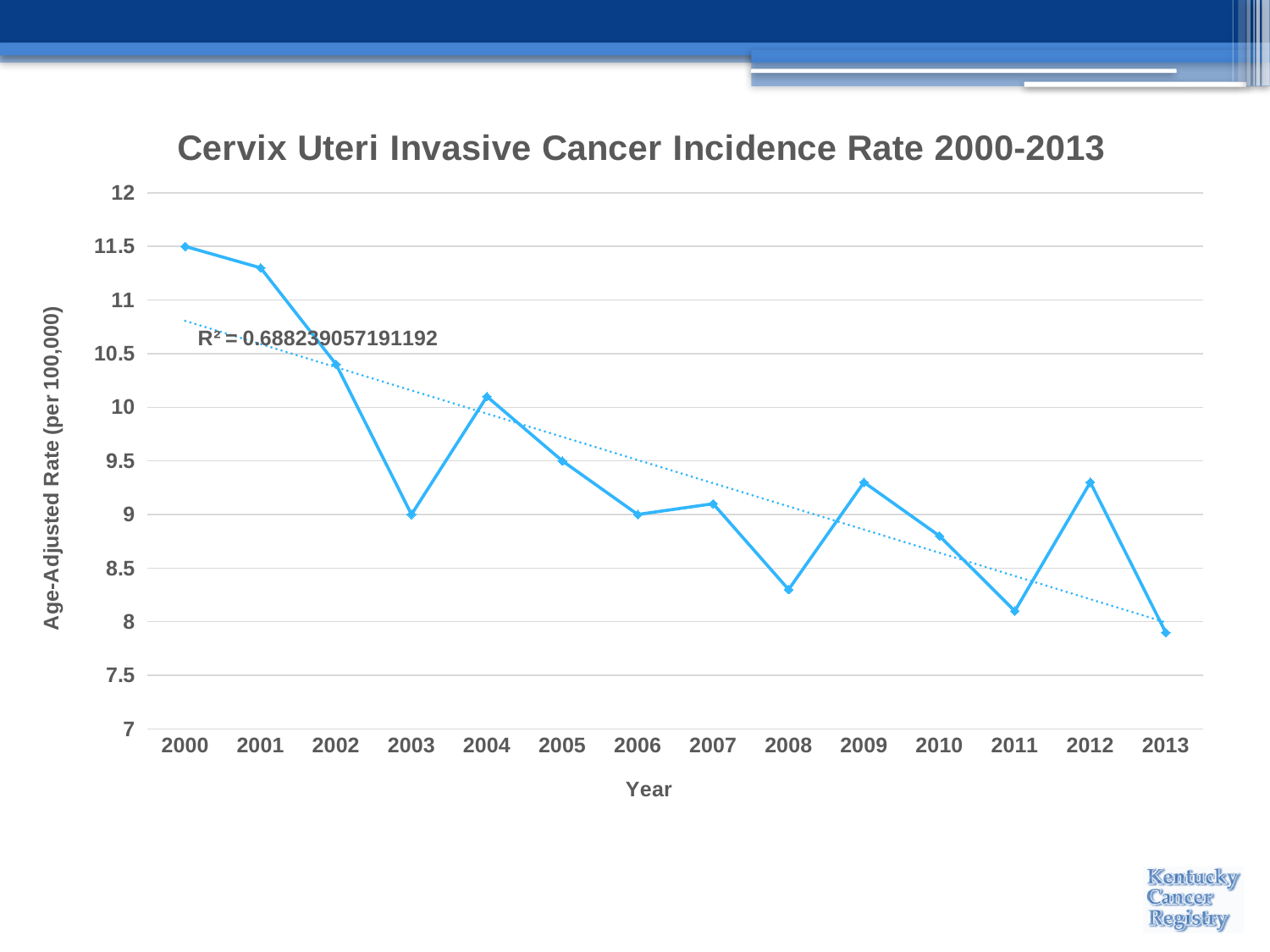
Which year has the lowest age-adjusted incidence rate? 2013 Is the value for 2008 greater or less than 8.5? less What is the age-adjusted rate for 2000? 11.5 Overall, do the incidence rates rise or fall from 2000 to 2013? fall Is the value for 2004 greater or less than 10? greater How many years are plotted on the x axis? 14 What is the age-adjusted rate for 2003? 9 Which year has the larger rate, 2008 or 2009? 2009 Which year has the highest age-adjusted incidence rate? 2000 Is the value for 2013 greater or less than 8? less What kind of chart is shown on the slide? line chart What is the title of the chart? Cervix Uteri Invasive Cancer Incidence Rate 2000-2013